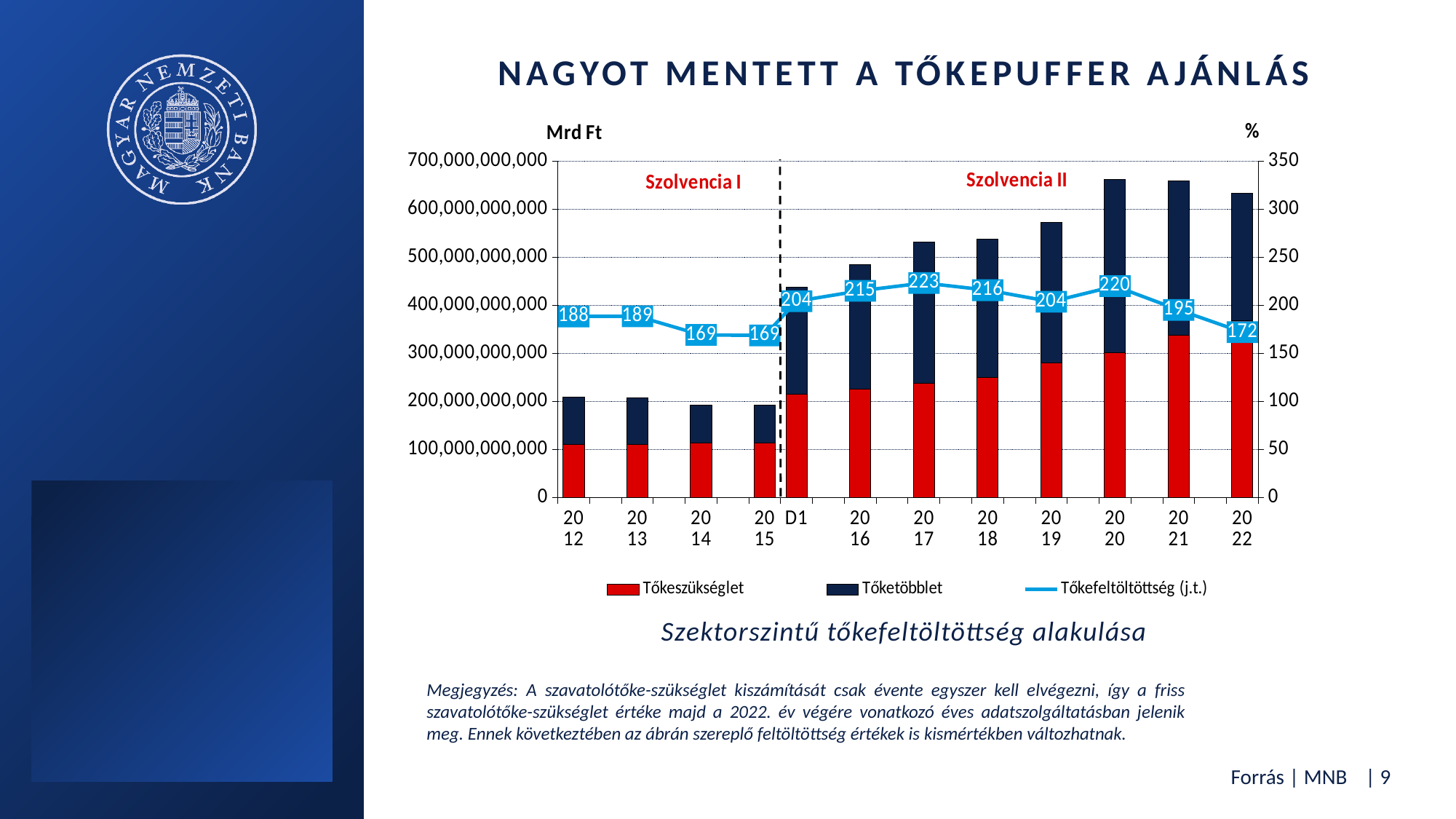
How many categories are shown on the x axis? 12 Is the total height of the stacked bar for 2020 greater or less than 600,000,000,000? greater Which is larger, the Tőkefeltöltöttség (j.t.) value for 2016 or for 2021? 2016 Between 2020 and 2022, does the Tőkefeltöltöttség (j.t.) line rise or fall? fall What is the difference between the Tőkefeltöltöttség (j.t.) values for 2017 and 2022? 51 What is the Tőkefeltöltöttség (j.t.) value for 2022? 172 What is the Tőkefeltöltöttség (j.t.) value for 2017? 223 In which year does the Tőkefeltöltöttség (j.t.) line reach its highest value? 2017 What is the Tőkefeltöltöttség (j.t.) value at D1? 204 How many series does the legend list? 3 What kind of chart is shown on the slide? A stacked bar chart combined with a line chart Is the Tőkeszükséglet value for 2021 greater or less than 300,000,000,000? greater